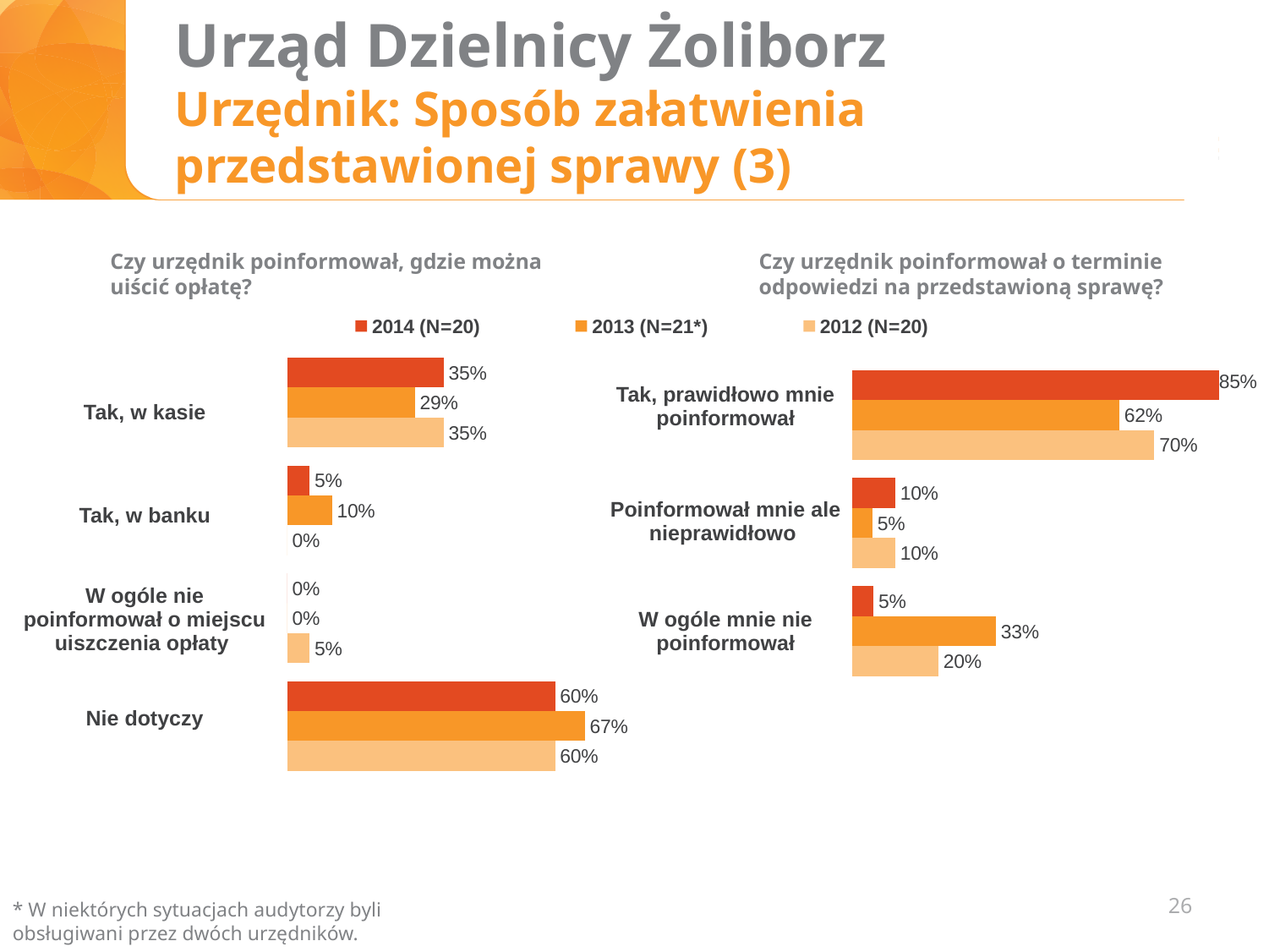
In the right chart ("Czy urzędnik poinformował o terminie odpowiedzi na przedstawioną sprawę?"), what is the 2013 value for "W ogóle mnie nie poinformował"? 33% How many series does the legend list? 3 What type of chart is used on this slide? Bar chart How many categories does the left chart ("Czy urzędnik poinformował, gdzie można uiścić opłatę?") show? 4 In the right chart ("Czy urzędnik poinformował o terminie odpowiedzi na przedstawioną sprawę?"), which year has the lowest value for "Tak, prawidłowo mnie poinformował"? 2013 In the right chart ("Czy urzędnik poinformował o terminie odpowiedzi na przedstawioną sprawę?"), what is the 2014 value for "Tak, prawidłowo mnie poinformował"? 85% In the left chart ("Czy urzędnik poinformował, gdzie można uiścić opłatę?"), which category has the highest 2014 value? Nie dotyczy In the left chart ("Czy urzędnik poinformował, gdzie można uiścić opłatę?"), which is larger for "Tak, w banku": the 2014 value or the 2013 value? 2013 In the left chart ("Czy urzędnik poinformował, gdzie można uiścić opłatę?"), what is the 2014 value for "Tak, w kasie"? 35% In the left chart ("Czy urzędnik poinformował, gdzie można uiścić opłatę?"), what is the 2013 value for "Nie dotyczy"? 67% In the right chart ("Czy urzędnik poinformował o terminie odpowiedzi na przedstawioną sprawę?"), what is the difference between the 2014 and 2013 values for "Tak, prawidłowo mnie poinformował"? 23 percentage points In the left chart ("Czy urzędnik poinformował, gdzie można uiścić opłatę?"), what is the difference between the 2013 and 2014 values for "Nie dotyczy"? 7 percentage points